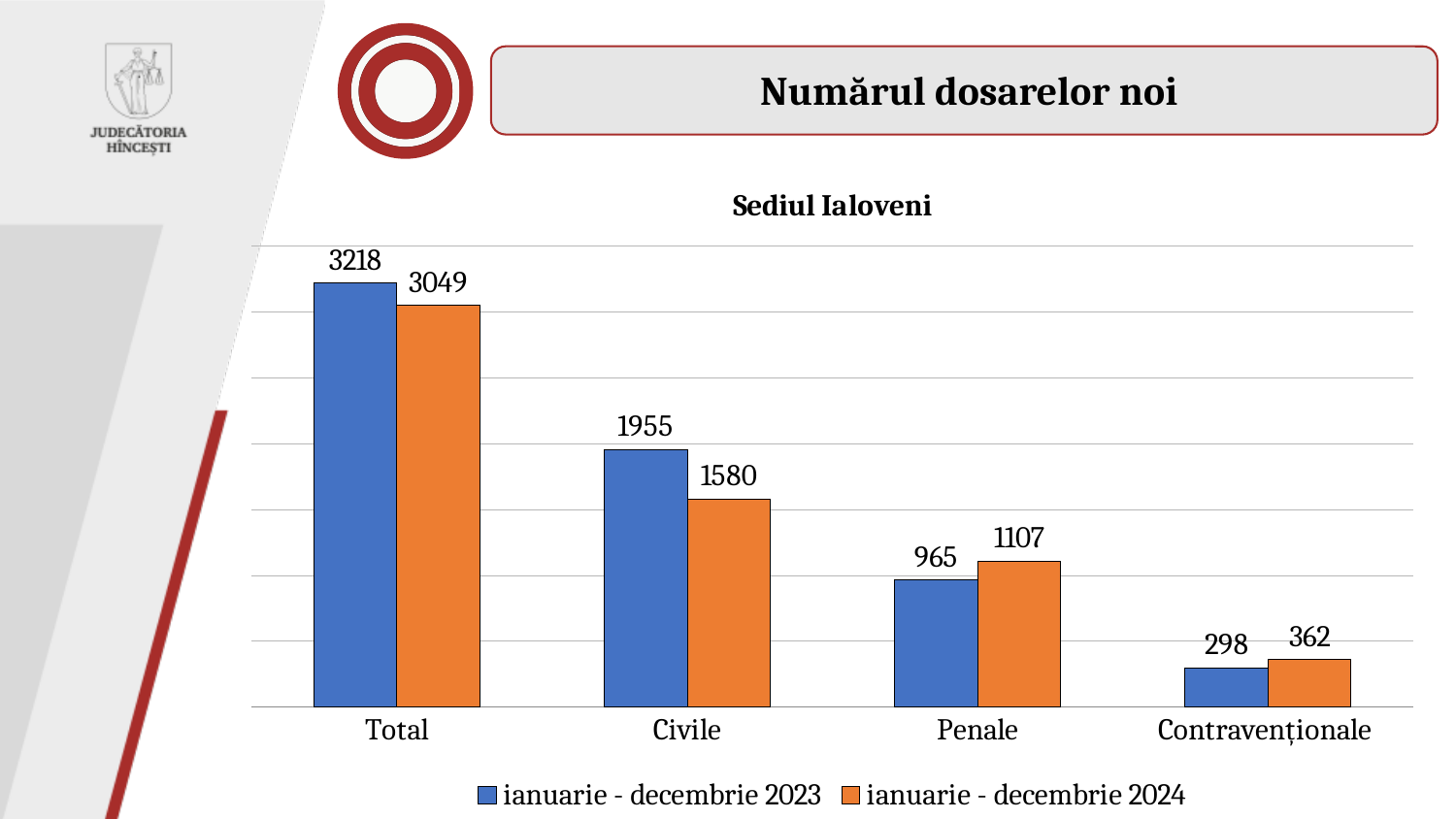
Which is larger for Penale: the 2023 value or the 2024 value? 2024 (1107) Which category has the lowest value in the 'ianuarie - decembrie 2024' series? Contravenționale What is the value for Contravenționale in the 'ianuarie - decembrie 2023' series? 298 What is the difference between the Total values for 2023 and 2024? 169 What is the value for Penale in the 'ianuarie - decembrie 2024' series? 1107 What is the difference between the Civile values for 2023 and 2024? 375 Which category has the highest value in the 'ianuarie - decembrie 2023' series? Total What is the value for Civile in the 'ianuarie - decembrie 2023' series? 1955 How many categories are shown on the x axis? 4 How many series does the legend list? 2 What kind of chart is shown on the slide? Bar chart What is the title of the chart? Sediul Ialoveni